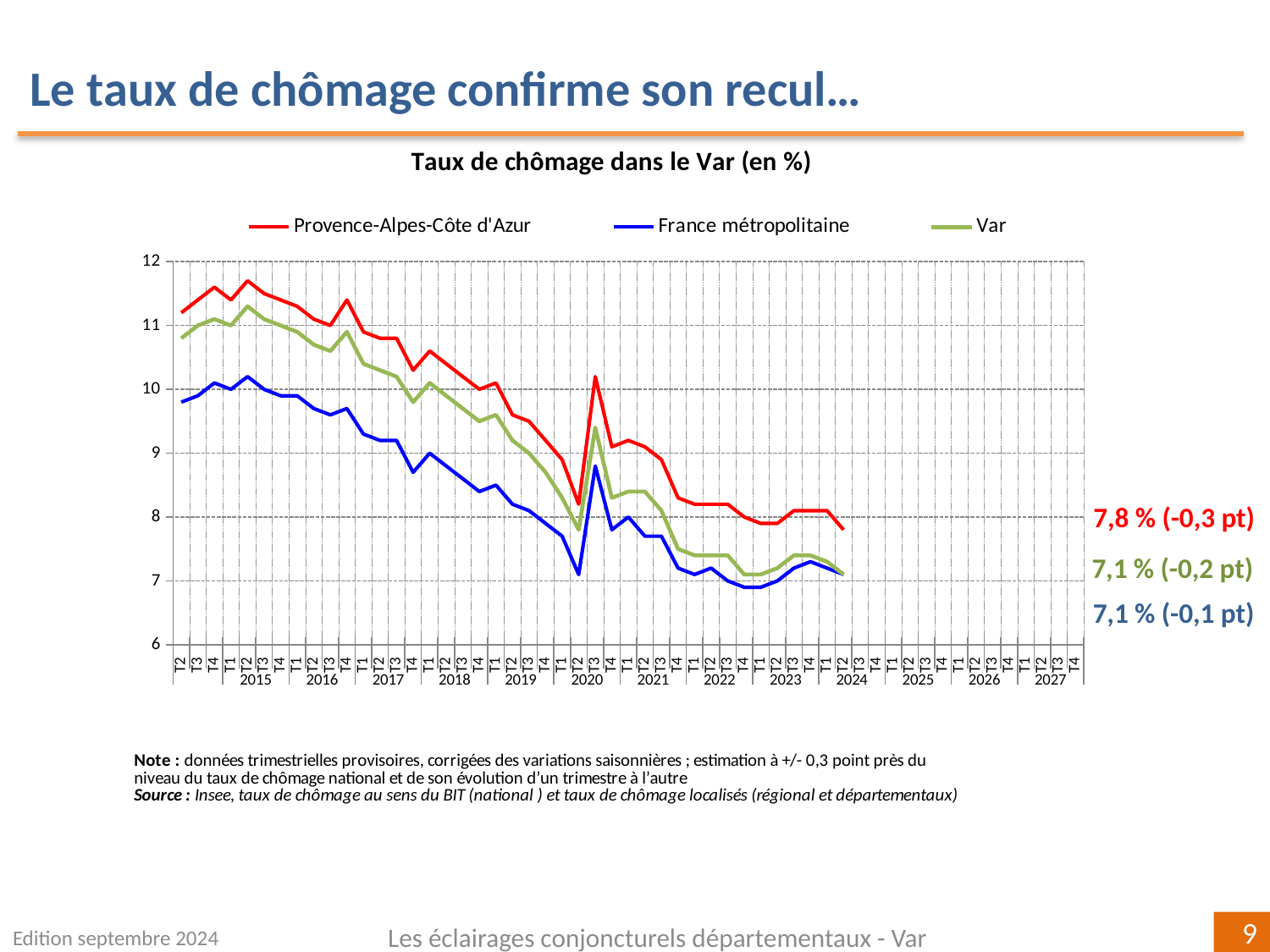
What is the difference between the latest Provence-Alpes-Côte d'Azur rate and the latest Var rate? 0,7 What is the latest unemployment rate shown for France métropolitaine? 7,1 % What is the title of the chart? Taux de chômage dans le Var (en %) By how much did the Provence-Alpes-Côte d'Azur rate change in the latest quarter, according to the annotation? -0,3 pt What is the latest unemployment rate shown for the Var? 7,1 % What kind of chart is shown on the slide? line chart What is the latest unemployment rate shown for Provence-Alpes-Côte d'Azur? 7,8 % How many series does the legend list? 3 Is the value for France métropolitaine at T2 2020 greater or less than 7.5? less Overall, do the unemployment rates rise or fall between 2014 and 2024? fall Which series has the highest value at the end of the period? Provence-Alpes-Côte d'Azur Is the value for the Var at T2 2014 greater or less than 10? greater